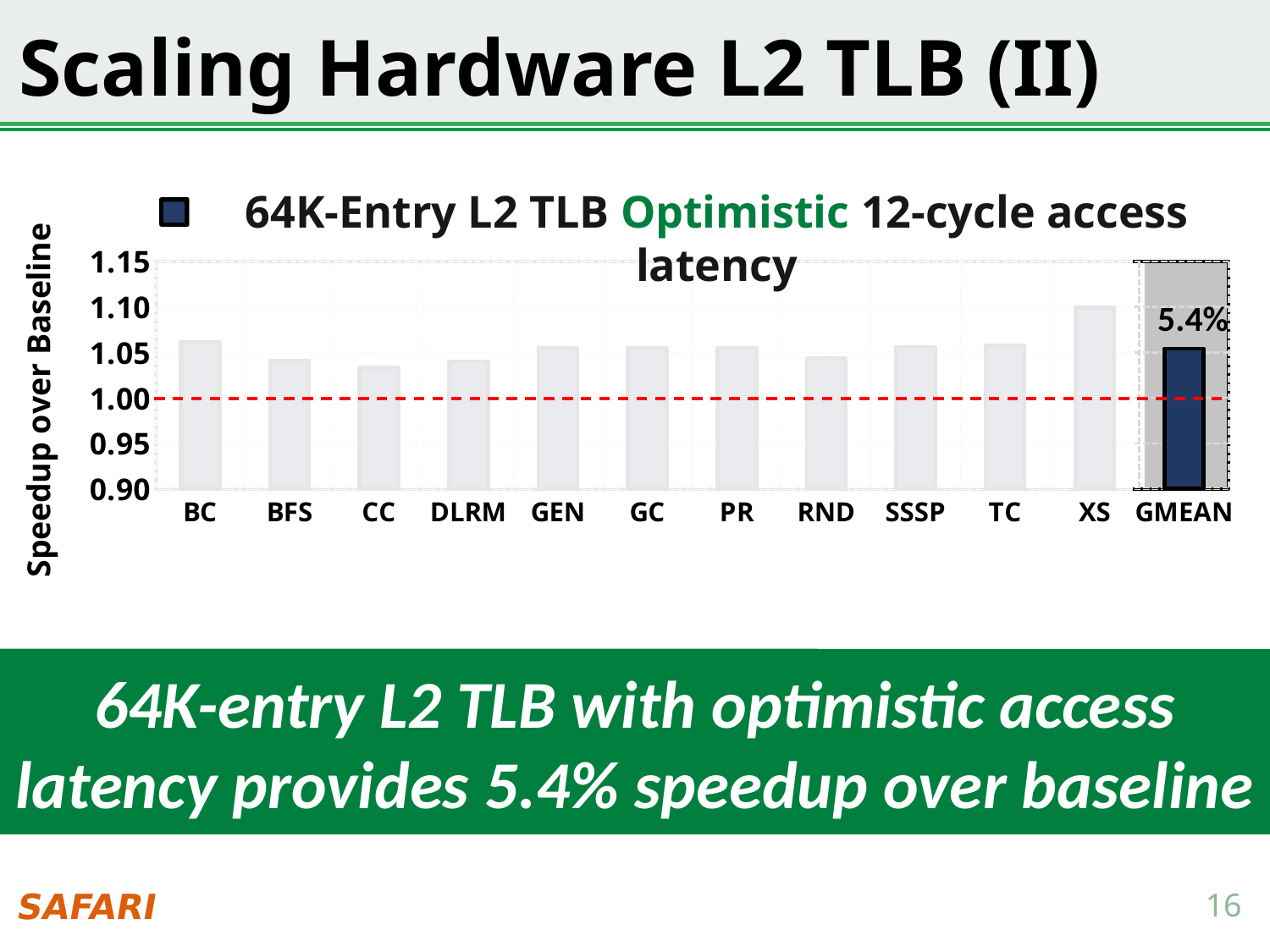
What is the title of the chart's y axis? Speedup over Baseline Is the speedup value for XS greater or less than 1.15? less Is the speedup value for XS greater or less than 1.05? greater Which has the larger speedup over baseline, BC or CC? BC Is the speedup value for CC greater or less than 1.05? less Which has the larger speedup over baseline, XS or BC? XS What speedup percentage is labelled on the GMEAN bar? 5.4% Which category has the highest speedup over baseline in the chart? XS How many series does the chart's legend list? 1 What kind of chart is shown on the slide? bar chart How many categories are shown along the x axis of the chart? 12